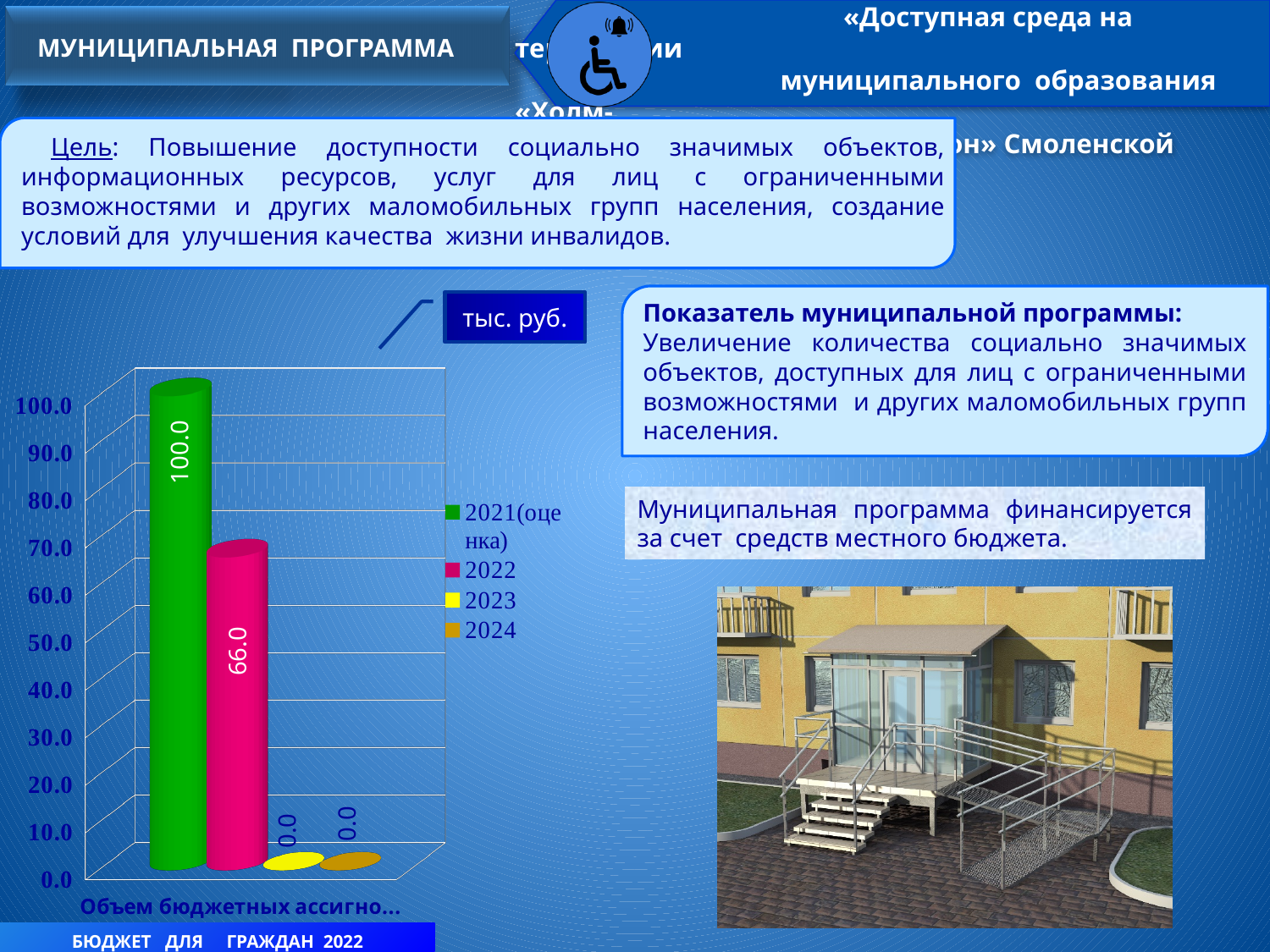
What is the value for 2023 on the chart? 0.0 What colour is the bar for 2022? pink What is the value for 2022 on the chart? 66.0 What is the difference between the values for 2021(оценка) and 2022? 34.0 What is the value for 2024 on the chart? 0.0 What is the value for 2021(оценка) on the chart? 100.0 Which is larger, the value for 2021(оценка) or the value for 2022? 2021(оценка) Which series has the highest value on the chart? 2021(оценка) Is the value for 2022 greater or less than 70.0? less How many series does the legend list? 4 What kind of chart is shown on the slide? bar chart What unit is shown in the box above the chart? тыс. руб.